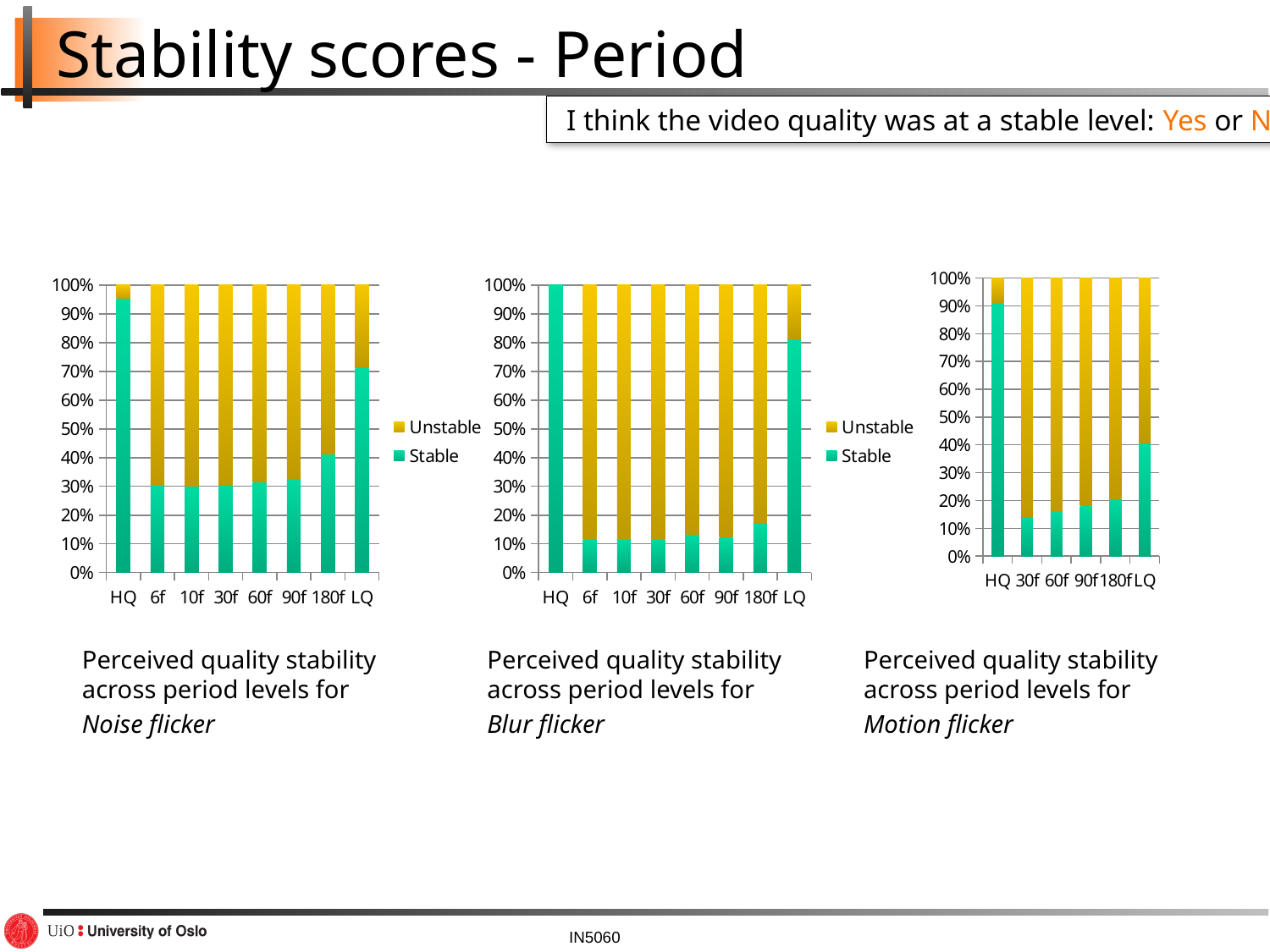
In the Blur flicker chart, is the Stable share for 6f greater or less than 20%? less In the Blur flicker chart, which has the larger Stable share, HQ or LQ? HQ In the Noise flicker chart, is the Stable share for LQ greater or less than 60%? greater In the Motion flicker chart, which category has the largest Stable share? HQ In the Blur flicker chart, which category has the largest Stable share? HQ What kind of chart is used for the Noise flicker chart on the left? Stacked bar chart How many period categories are shown on the x axis of the Blur flicker chart in the middle? 8 In the Noise flicker chart, which category has the largest Stable share? HQ What are the two legend entries shown for the Noise flicker and Blur flicker charts? Unstable and Stable How many categories are shown on the x axis of the Motion flicker chart on the right? 6 In the Motion flicker chart, is the Stable share for LQ greater or less than 50%? less How many series does the legend of the Noise flicker chart list? 2